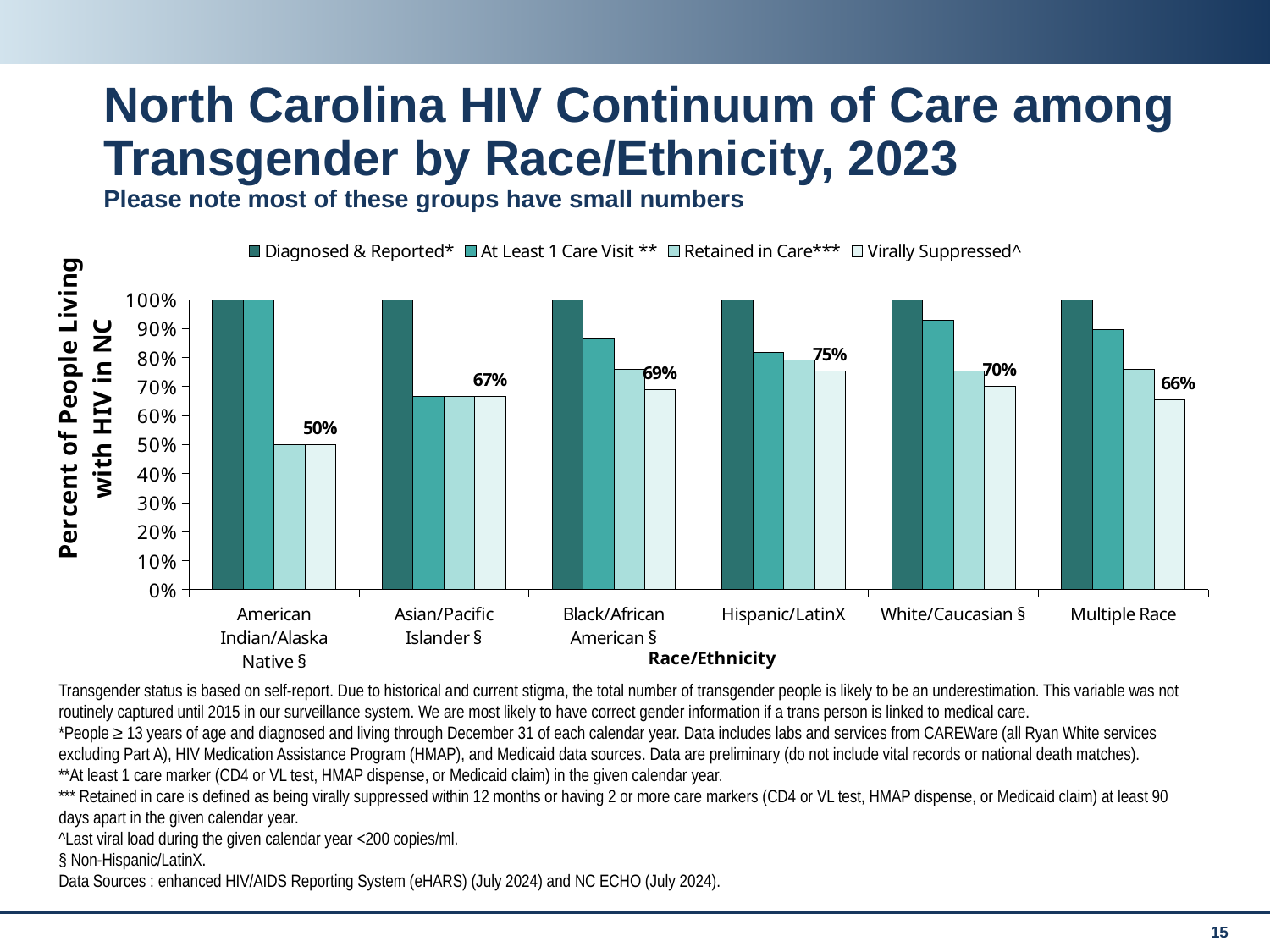
Which race/ethnicity group has the highest Virally Suppressed value? Hispanic/LatinX What is the Virally Suppressed value for Hispanic/LatinX? 75% What is the Virally Suppressed value for Multiple Race? 66% What is the Virally Suppressed value for American Indian/Alaska Native? 50% Is the At Least 1 Care Visit value for White/Caucasian greater or less than 90%? greater How many race/ethnicity groups are shown on the x axis? 6 Which race/ethnicity group has the lowest Virally Suppressed value? American Indian/Alaska Native Which has a higher Virally Suppressed value, White/Caucasian or Black/African American? White/Caucasian Is the Retained in Care value for American Indian/Alaska Native greater or less than 60%? less What is the difference between the Virally Suppressed values for Hispanic/LatinX and American Indian/Alaska Native? 25 percentage points What kind of chart is shown on the slide? Bar chart How many series does the legend list? 4